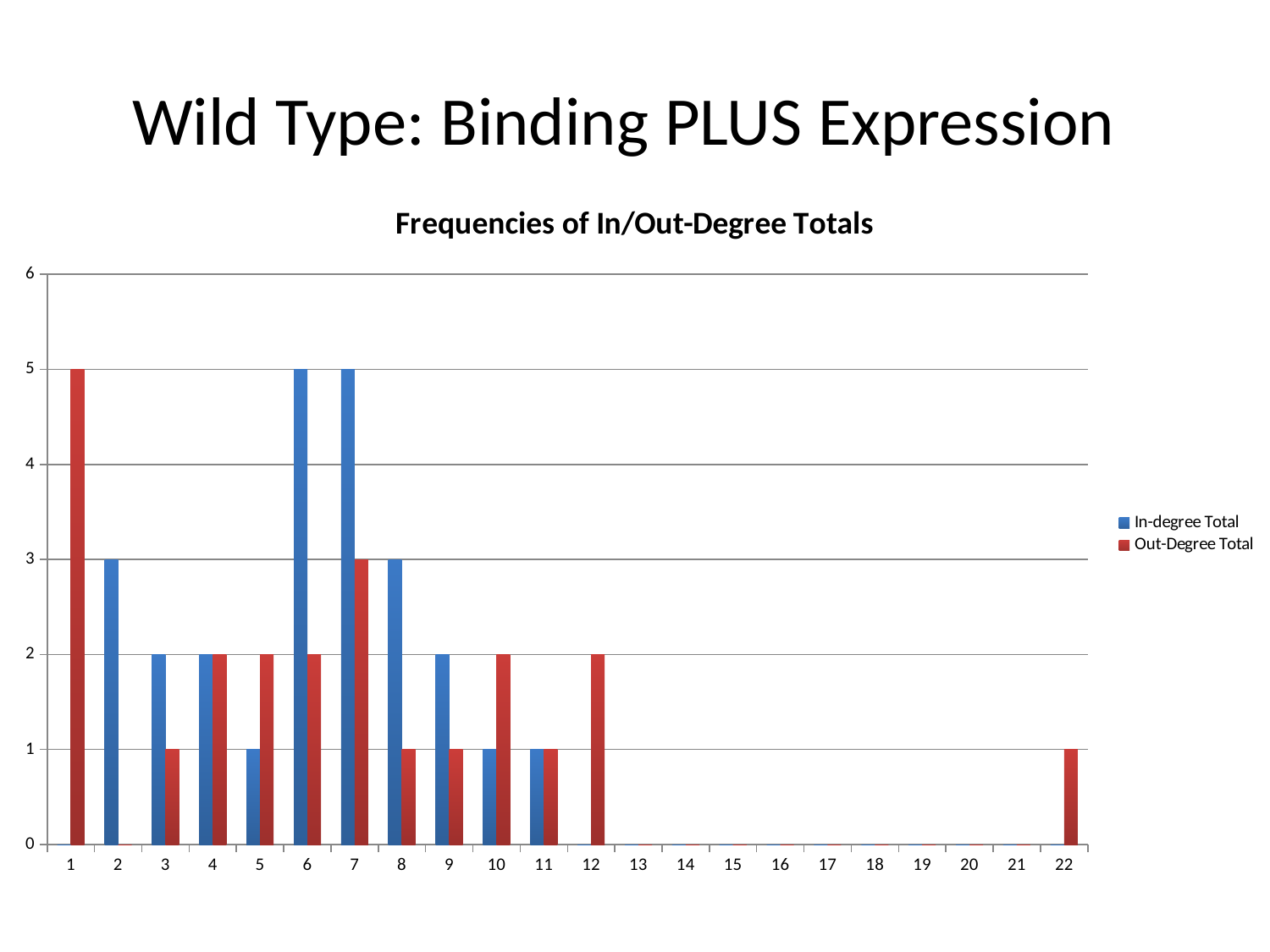
What type of chart is shown on the slide? bar chart How many series does the legend list? 2 What is the title of the chart? Frequencies of In/Out-Degree Totals What is the In-degree Total value for category 6? 5 Which category has the highest Out-Degree Total? 1 What is the Out-Degree Total value for category 7? 3 How many categories are shown on the x axis? 22 What is the Out-Degree Total value for category 1? 5 Is the In-degree Total for category 7 greater or less than 4? greater What is the In-degree Total value for category 2? 3 What is the difference between the In-degree Total and the Out-Degree Total at category 7? 2 Which is larger at category 8, the In-degree Total or the Out-Degree Total? In-degree Total